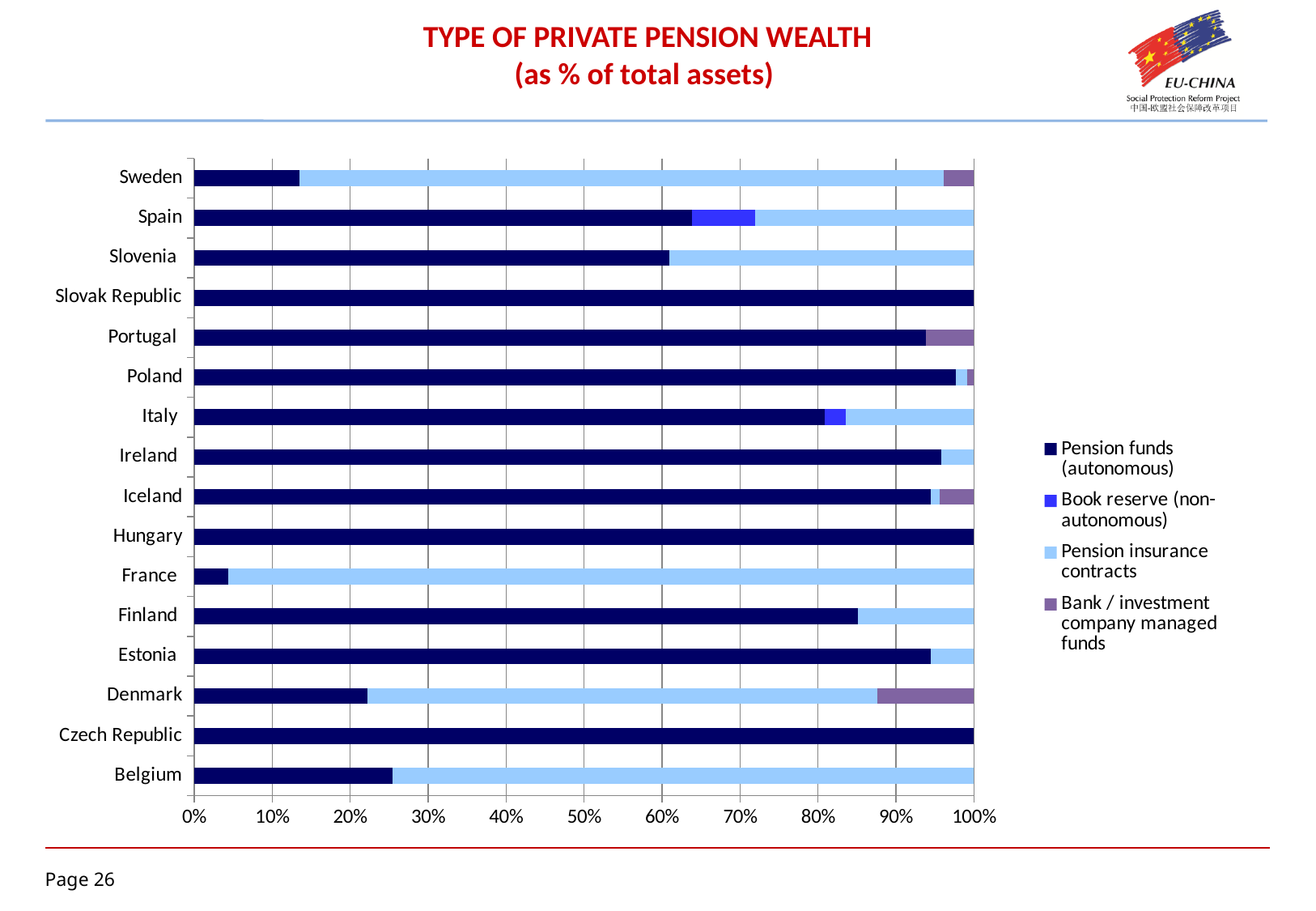
What type of chart is shown on the slide? Stacked bar chart Is the Pension funds (autonomous) value for France greater or less than 10%? less Is the Pension funds (autonomous) value for Denmark greater or less than 30%? less What share of the Slovak Republic's private pension wealth is in Pension funds (autonomous)? 100% Which has a larger Pension funds (autonomous) share, France or Belgium? Belgium How many series does the legend list? 4 Is the Pension funds (autonomous) value for Sweden greater or less than 20%? less Which has a larger Bank / investment company managed funds share, Denmark or Sweden? Denmark Which country has the smallest share of Pension funds (autonomous)? France Which series is shown in light blue in the legend? Pension insurance contracts How many countries are listed on the chart? 16